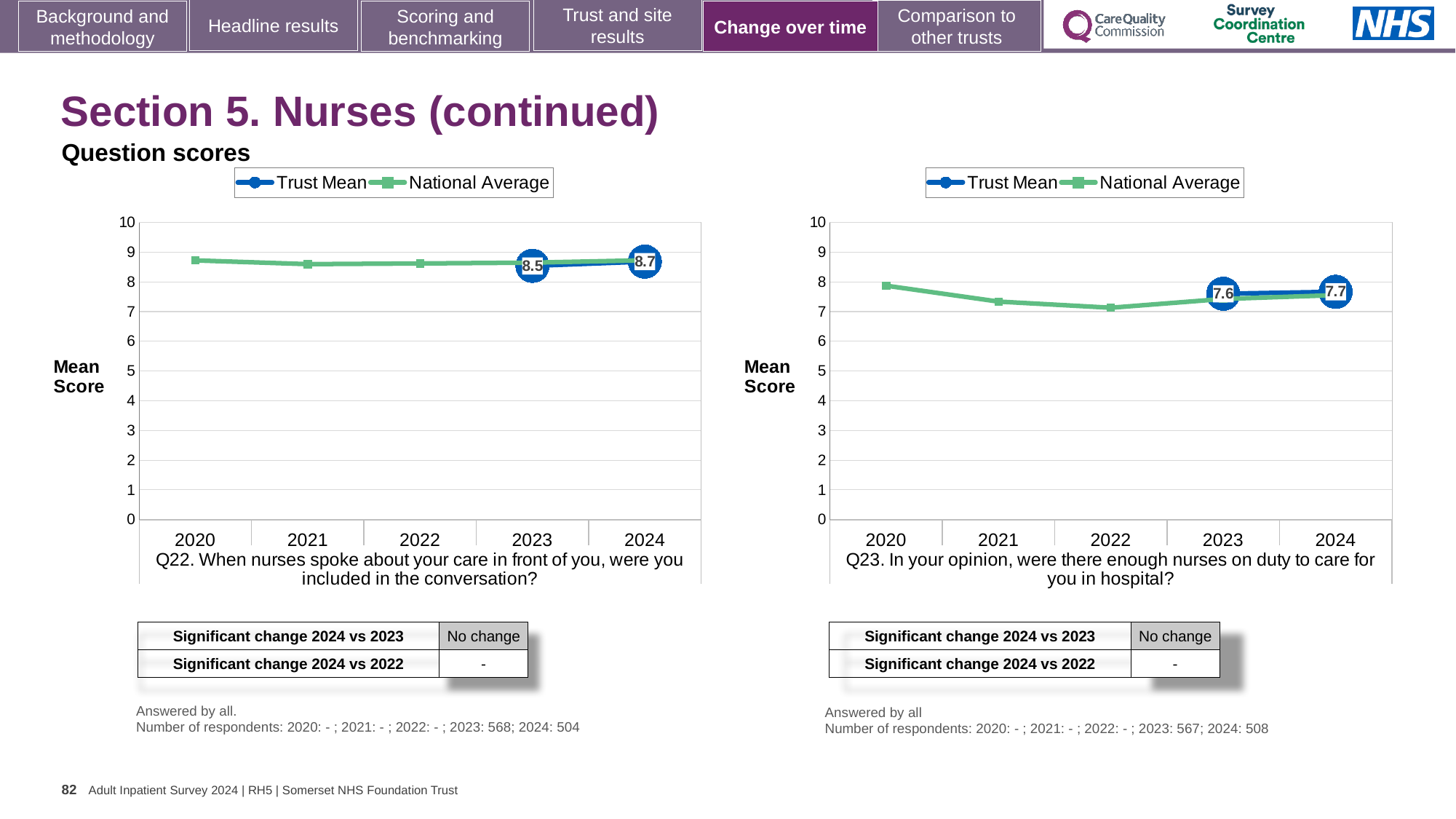
How many years are shown on the x axis of the Q23 chart on the right? 5 In the Q22 chart on the left, by how much did the Trust Mean change from 2023 to 2024? 0.2 How many series does the legend of the Q22 chart on the left list? 2 In the Q22 chart on the left, is the National Average for 2020 greater or less than 8? greater In the Q23 chart on the right, does the Trust Mean rise or fall from 2023 to 2024? rise In the Q23 chart on the right, what is the Trust Mean value for 2024? 7.7 In the Q23 chart on the right, is the National Average for 2022 greater or less than 8? less In the Q23 chart on the right, what is the difference between the Trust Mean for 2024 and 2023? 0.1 In the Q22 chart on the left, what is the Trust Mean value for 2024? 8.7 In the Q22 chart on the left, is the Trust Mean higher in 2023 or 2024? 2024 In the Q22 chart on the left, what is the Trust Mean value for 2023? 8.5 In the Q23 chart on the right, what is the Trust Mean value for 2023? 7.6